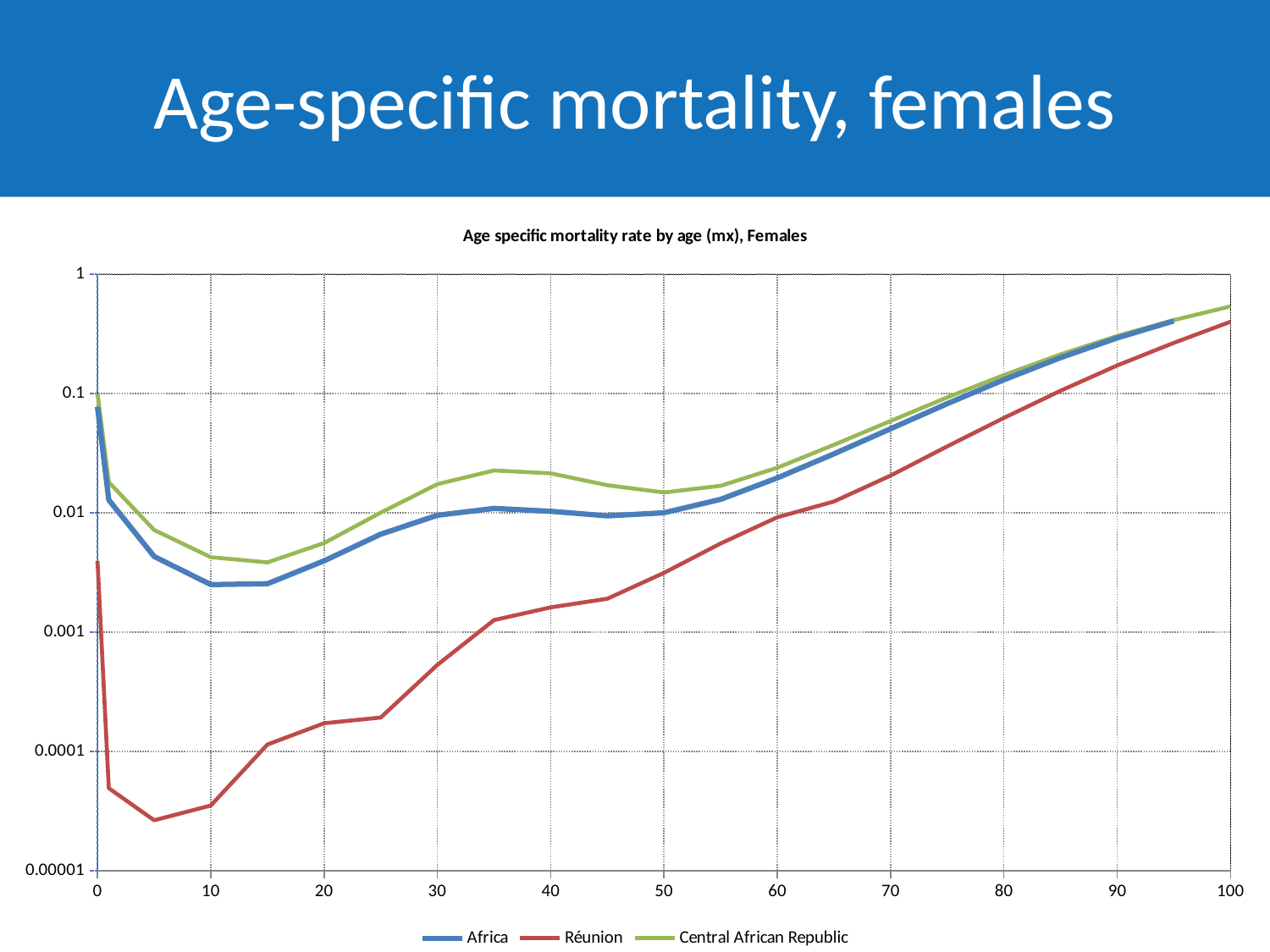
What kind of chart is shown on the slide? line chart Which series has the lowest value at age 20? Réunion How many series does the legend list? 3 Is the value for Réunion at age 100 greater or less than 0.1? greater Is the value for Africa at age 10 greater or less than 0.01? less At age 5, which series has the larger value, Africa or Réunion? Africa Does the Réunion line rise or fall between age 50 and age 100? rise Which colour is used for the Réunion line? red Is the value for Central African Republic at age 35 greater or less than 0.01? greater What is the title printed above the chart? Age specific mortality rate by age (mx), Females